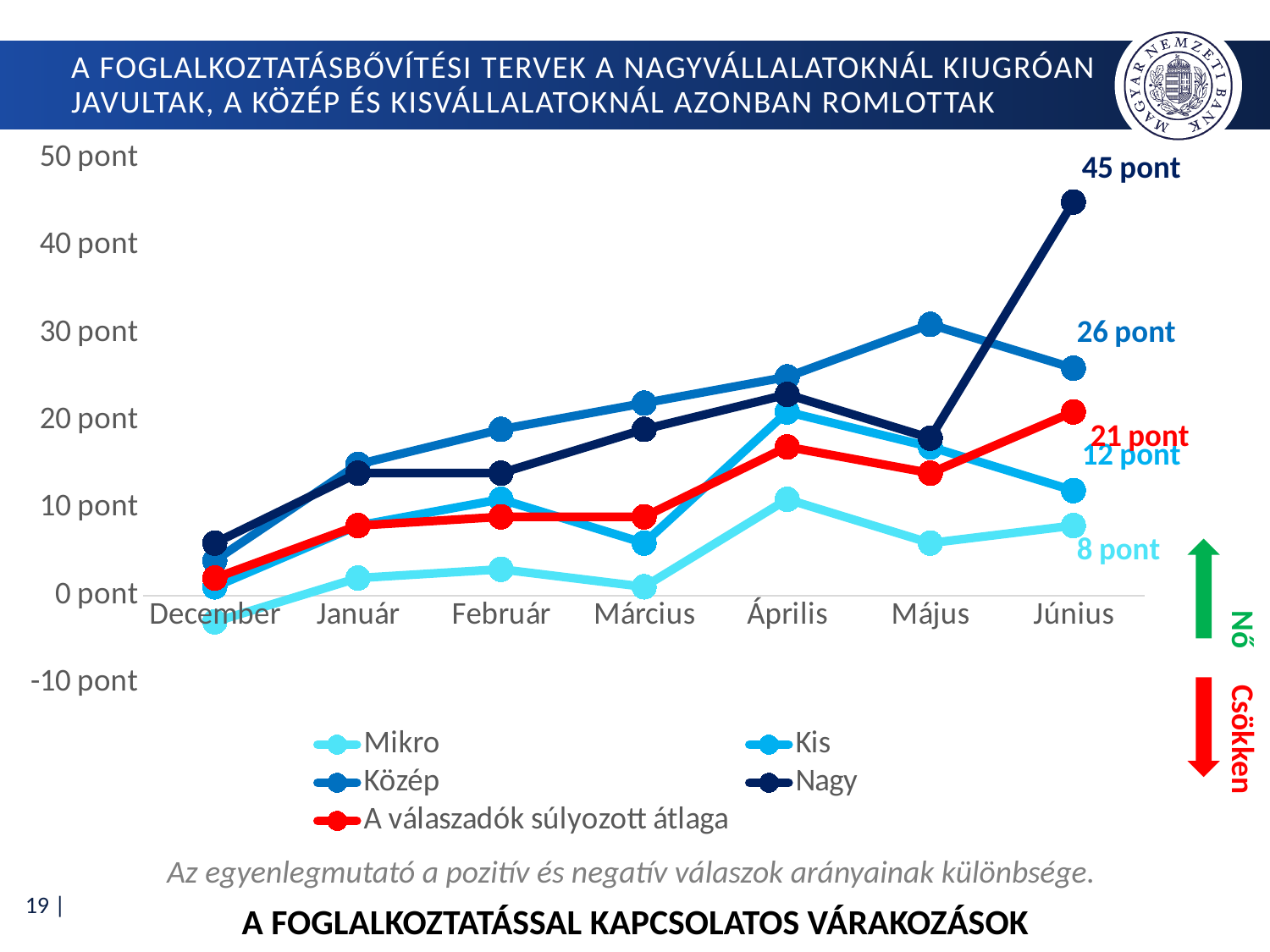
Which series has the lowest value in Június? Mikro How many months are shown on the x axis? 7 What is the value for Nagy in Június? 45 pont Is the value for Nagy in Április greater or less than 20 pont? greater What kind of chart is shown on the slide? line chart What is the value for Közép in Június? 26 pont What is the value for Kis in Június? 12 pont What is the value for A válaszadók súlyozott átlaga in Június? 21 pont What is the difference between the Nagy and Közép values in Június? 19 pont What is the value for Mikro in Június? 8 pont How many series does the legend list? 5 Which series has the highest value in Június? Nagy